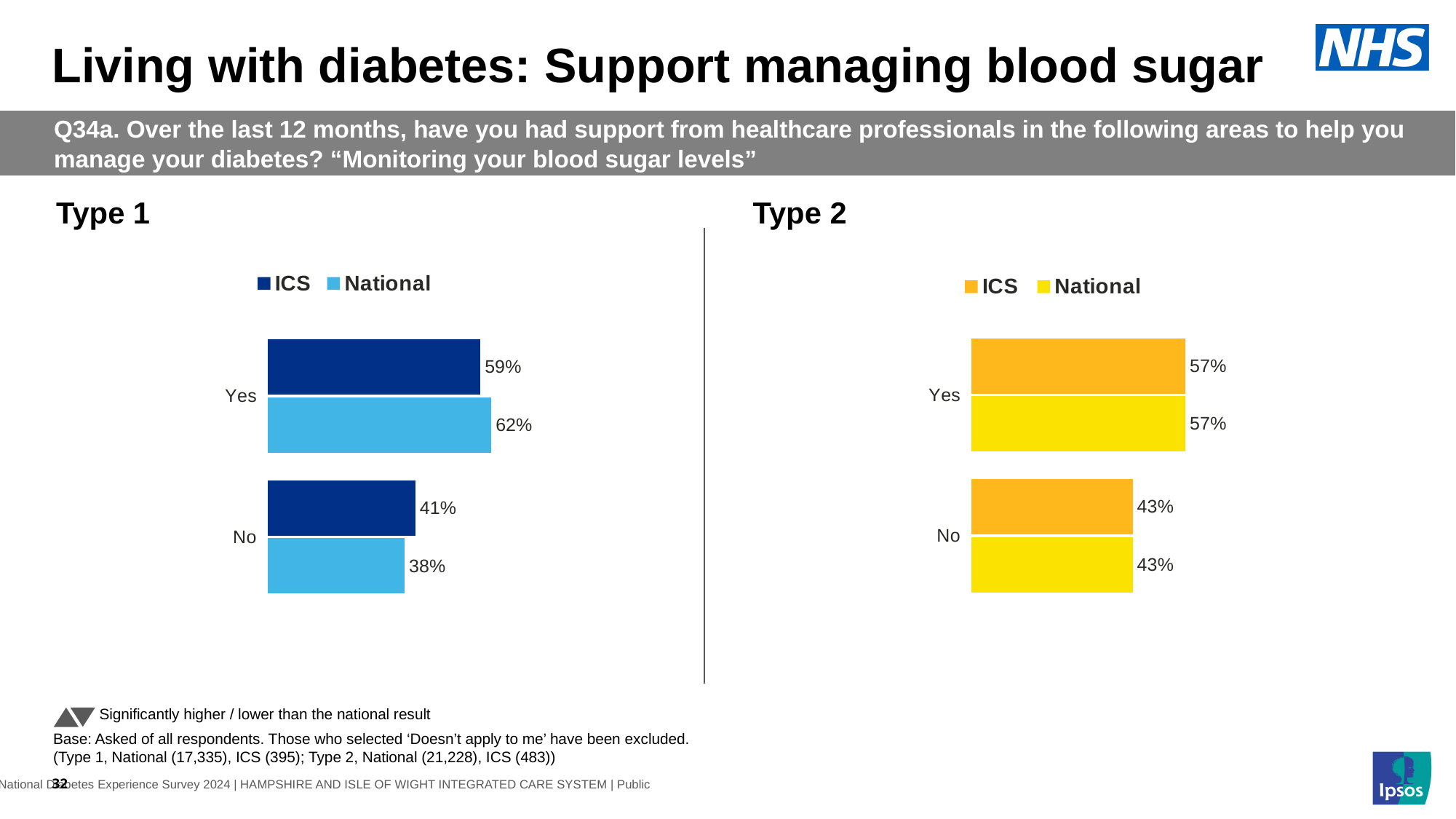
In the Type 2 chart, which category has the highest ICS value? Yes In the Type 1 chart, what is the difference between the National and ICS values for Yes? 3 percentage points In the Type 1 chart, what is the National value for No? 38% In the Type 1 chart, what is the ICS value for Yes? 59% In the Type 1 chart, which is larger for No: ICS or National? ICS How many categories are shown in the Type 1 chart? 2 In the Type 2 chart, what colour represents the National series? Yellow In the Type 2 chart, what is the National value for Yes? 57% What kind of chart is the Type 2 chart? Bar chart In the Type 2 chart, what is the ICS value for No? 43% In the Type 1 chart, which category has the lowest National value? No How many series does the legend of the Type 2 chart list? 2